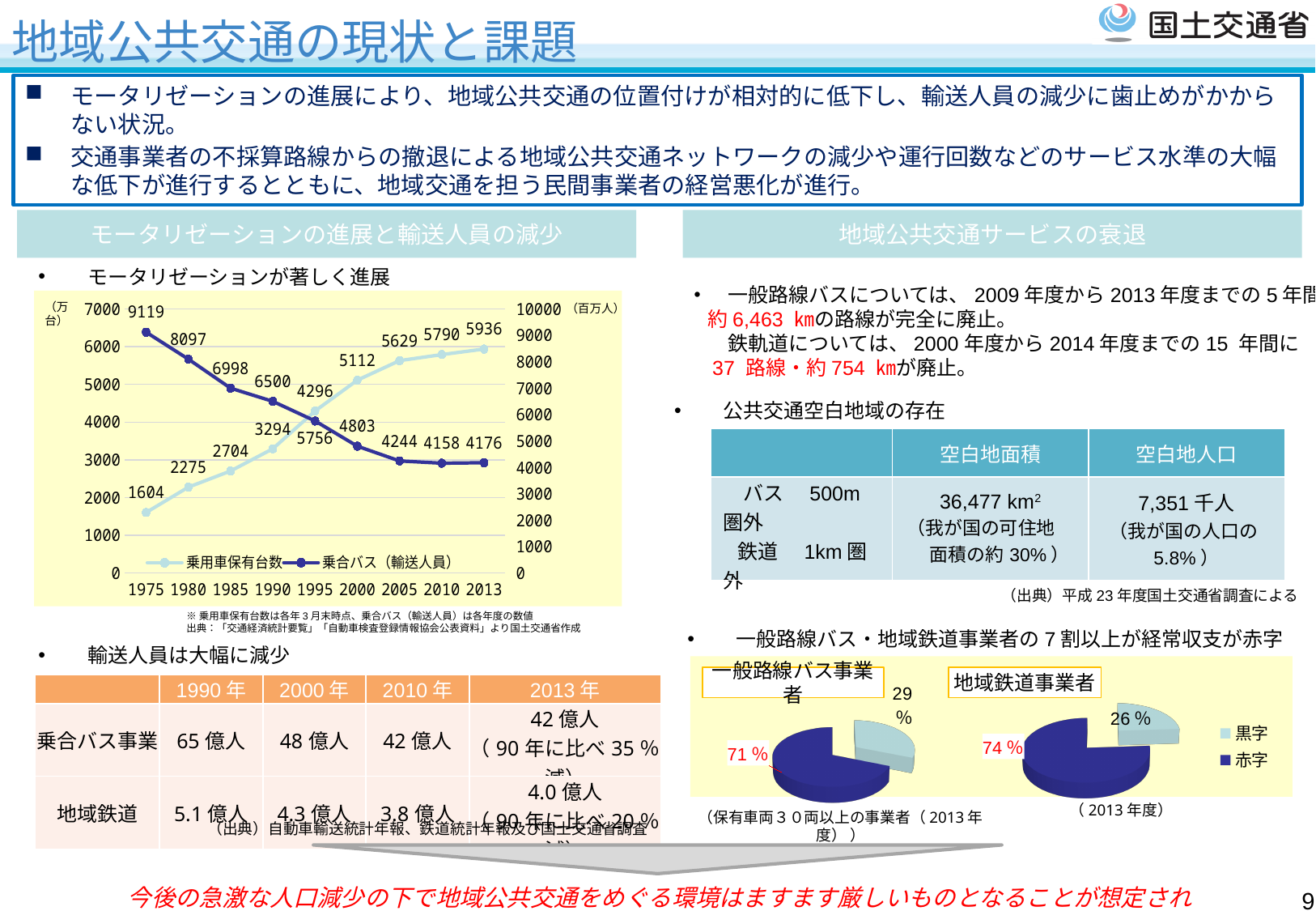
一般路線バス事業者の円グラフで、赤字の割合は何％ですか？ 71％ 左の折れ線グラフで、2000年の乗用車保有台数と乗合バス（輸送人員）ではどちらの値が大きいですか？ 乗用車保有台数 左の折れ線グラフのx軸には年がいくつ示されていますか？ 9 地域鉄道事業者の円グラフで、黒字の割合は何％ですか？ 26％ 左の折れ線グラフで、乗用車保有台数が最も高いのは何年ですか？ 2013 右下の「一般路線バス事業者」と「地域鉄道事業者」のグラフはどの種類のグラフですか？ 円グラフ 左の折れ線グラフで、1975年の乗合バス（輸送人員）の値はいくつですか？ 9119 左の折れ線グラフの凡例には系列がいくつありますか？ 2 左の折れ線グラフで、乗用車保有台数は1975年から2013年にかけて増加していますか、減少していますか？ 増加 左の折れ線グラフで、乗合バス（輸送人員）が最も低いのは何年ですか？ 2010 左の折れ線グラフで、2013年の乗用車保有台数の値はいくつですか？ 5936 左の折れ線グラフで、乗合バス（輸送人員）の1975年と2013年の値の差はいくつですか？ 4943